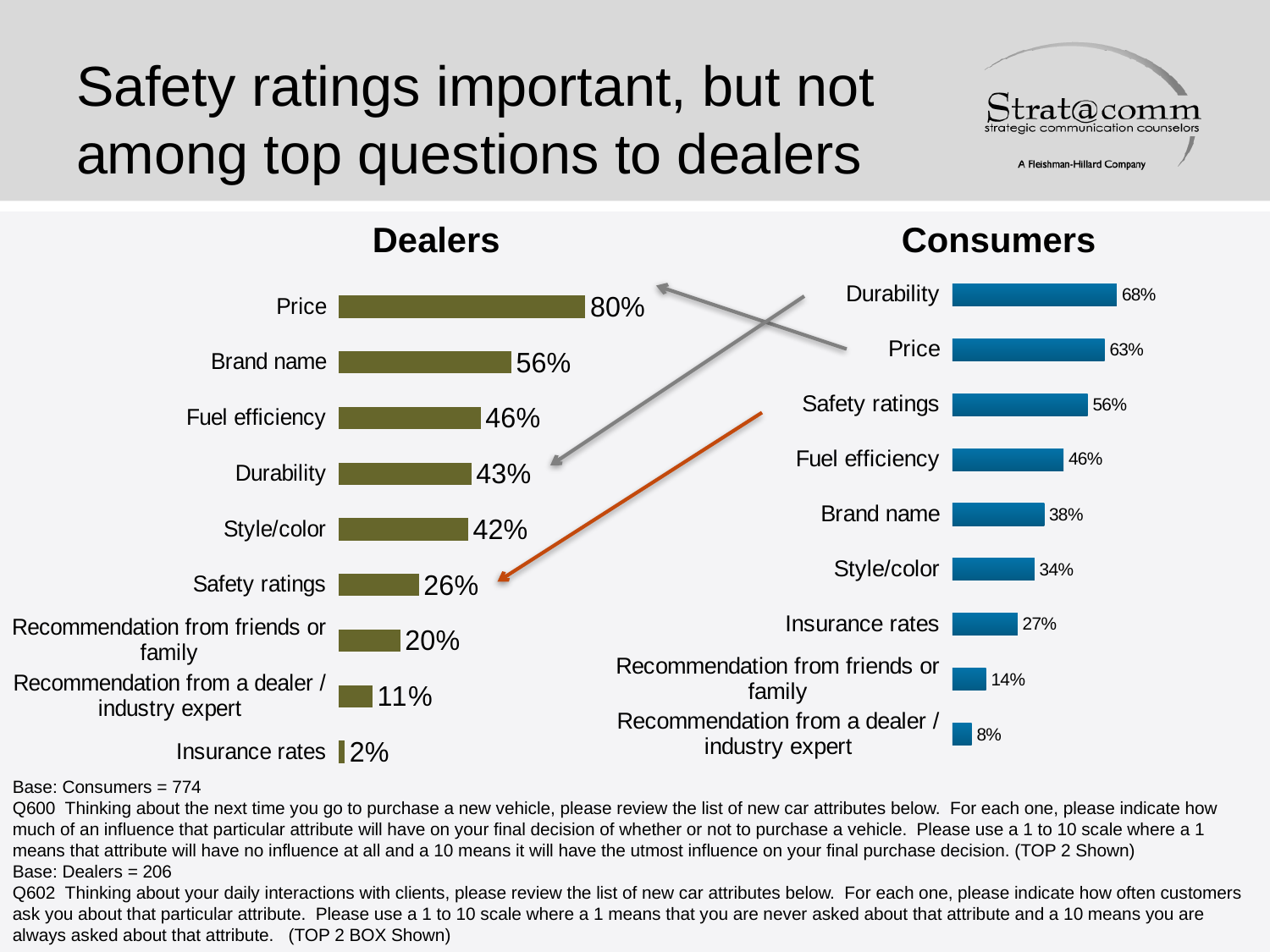
In the Dealers chart, what is the value for Price? 80% In the Consumers chart, which category has the lowest value? Recommendation from a dealer / industry expert In the Dealers chart, what is the difference between Price and Brand name? 24% Which is larger: Brand name in the Dealers chart or Brand name in the Consumers chart? Dealers In the Consumers chart, what is the value for Insurance rates? 27% In the Dealers chart, what is the value for Safety ratings? 26% In the Consumers chart, which category has the highest value? Durability What type of chart is the Consumers chart? Bar chart In the Dealers chart, which category has the lowest value? Insurance rates In the Consumers chart, what is the value for Durability? 68% How many categories does the Dealers chart show? 9 In the Consumers chart, what is the difference between Safety ratings and Fuel efficiency? 10%